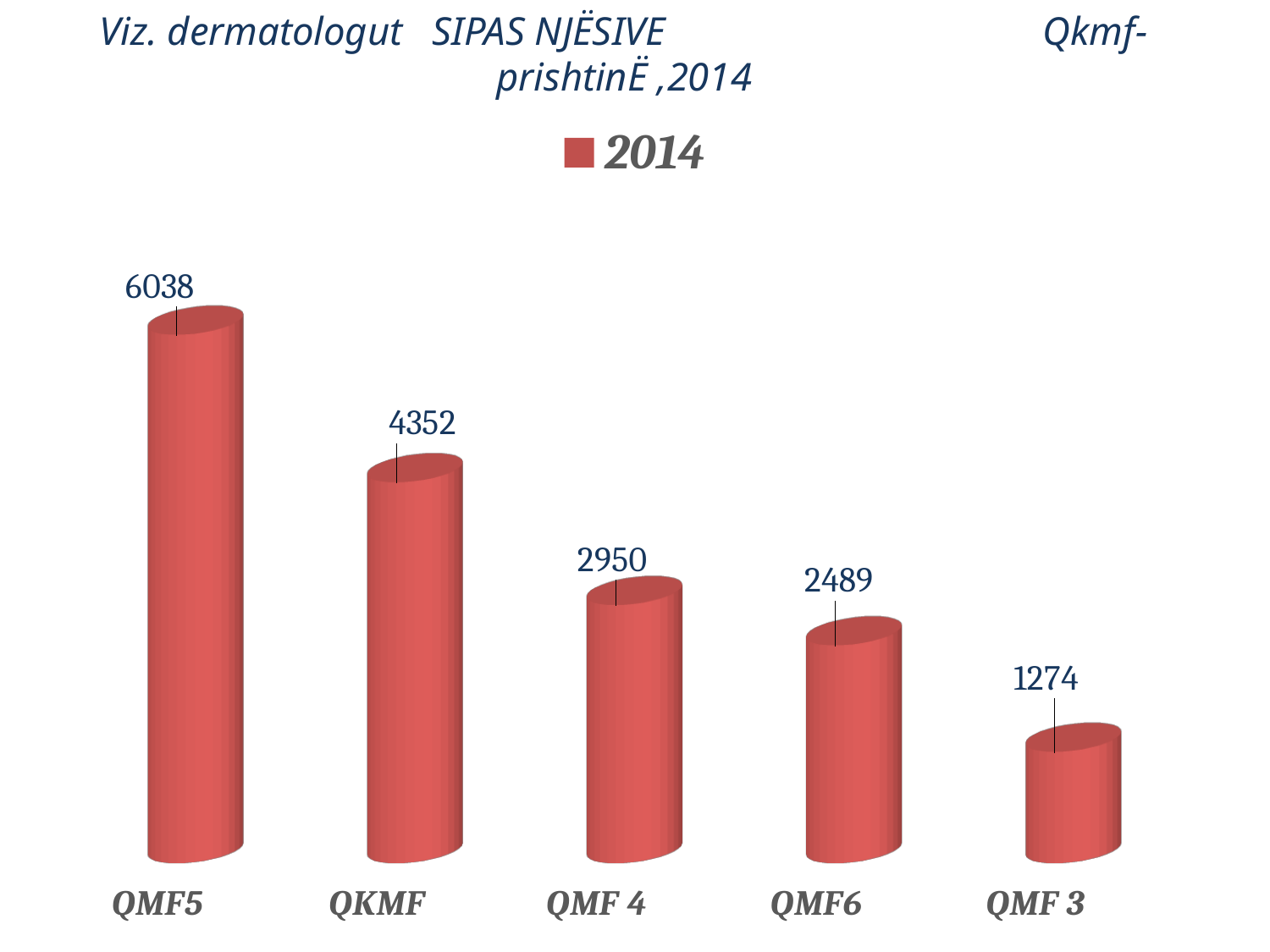
What is the value for QMF 4? 2950 What is the value for QKMF? 4352 What is the value for QMF5? 6038 What series does the legend list? 2014 Which category has the lowest value? QMF 3 What is the difference between the values for QMF5 and QKMF? 1686 How many categories are shown in the chart? 5 What is the value for QMF6? 2489 What is the value for QMF 3? 1274 What kind of chart is shown on the slide? Bar chart Which is larger, the value for QMF 4 or the value for QMF6? QMF 4 Which category has the highest value? QMF5